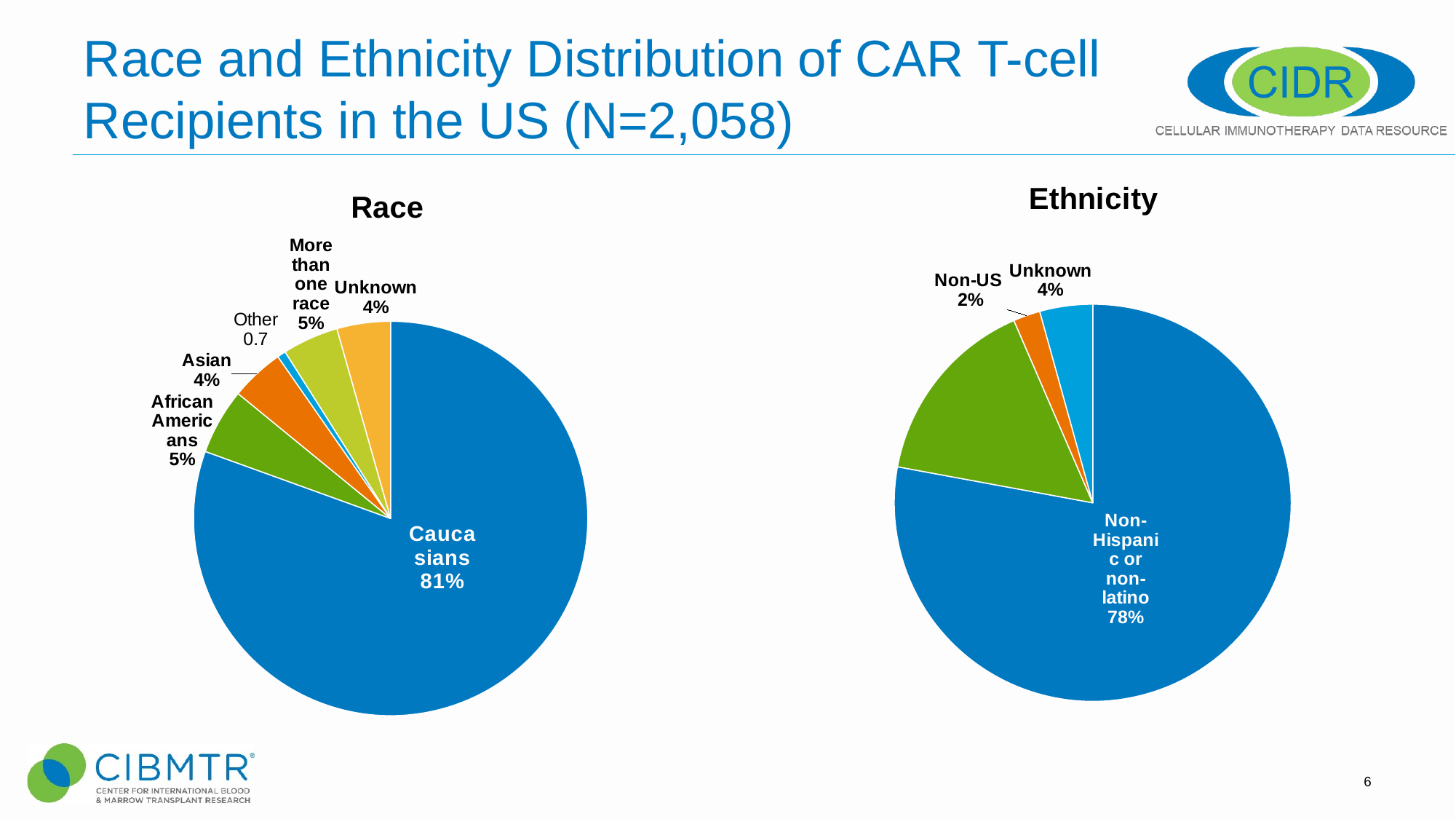
In the Race pie chart, how many percentage points larger is the Caucasians share than the African Americans share? 76 percentage points In the Race pie chart, what is the value shown for Unknown? 4% In the Race pie chart, what is the value shown for More than one race? 5% How many slices does the Race pie chart have? 6 In the Ethnicity pie chart, which is larger, Unknown or Non-US? Unknown In the Race pie chart, which category has the largest slice? Caucasians In the Ethnicity pie chart, what is the difference between the Unknown and Non-US shares? 2 percentage points What type of chart is used for the Race and Ethnicity distributions on this slide? Pie chart In the Race pie chart, which category has the smallest slice? Other In the Ethnicity pie chart, what is the value shown for Non-US? 2% In the Race pie chart, what percentage of recipients are Caucasians? 81% In the Ethnicity pie chart, what percentage is labelled Non-Hispanic or non-latino? 78%